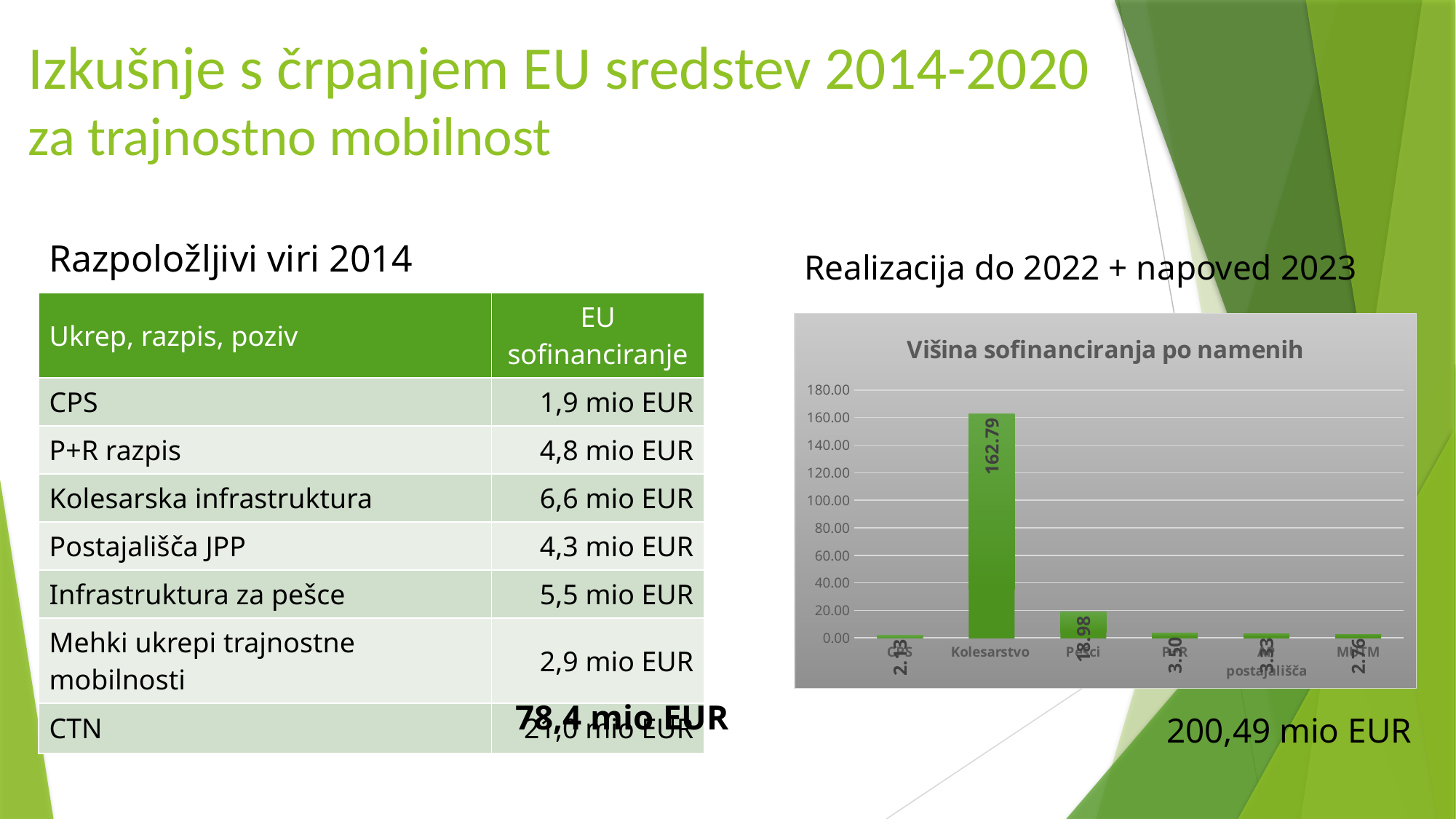
What is the value for Kolesarstvo? 162.79 What is the title of the chart? Višina sofinanciranja po namenih Which category has the highest value in the chart? Kolesarstvo What is the difference between the values for Kolesarstvo and Pešci? 143.81 Which is larger, the value for Kolesarstvo or the value for Pešci? Kolesarstvo What kind of chart is shown on the slide? bar chart What is the value for Pešci? 18.98 Is the value for Pešci greater or less than 40? less How many categories (bars) are shown in the chart? 6 What colour are the bars in the chart? green Is the value for Kolesarstvo greater or less than 140? greater